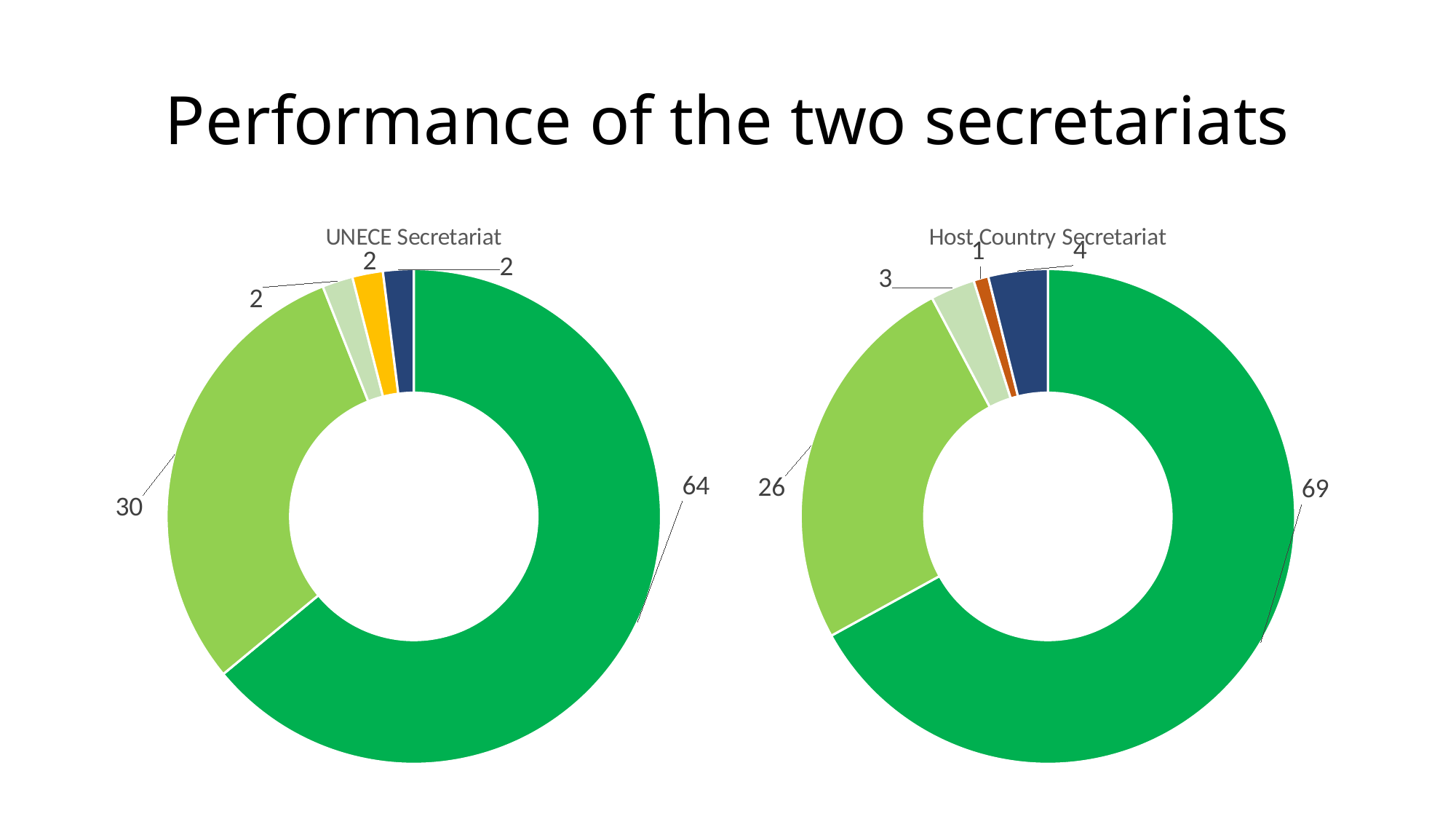
What is the title of the chart on the right side of the slide? Host Country Secretariat In the Host Country Secretariat chart, what is the value of the largest slice? 69 In the UNECE Secretariat chart, what is the value of the yellow slice? 2 In the Host Country Secretariat chart, what is the value of the smallest slice? 1 In the UNECE Secretariat chart, what is the value of the largest slice? 64 In the UNECE Secretariat chart, what is the value of the light green slice? 30 In the UNECE Secretariat chart, what is the difference between the largest slice (64) and the second largest slice (30)? 34 What type of chart is used for the UNECE Secretariat data? doughnut chart How many slices does the UNECE Secretariat chart have? 5 Which chart has the larger biggest slice, UNECE Secretariat or Host Country Secretariat? Host Country Secretariat In the Host Country Secretariat chart, what is the value of the dark navy slice? 4 In the Host Country Secretariat chart, what is the value of the light green slice? 26